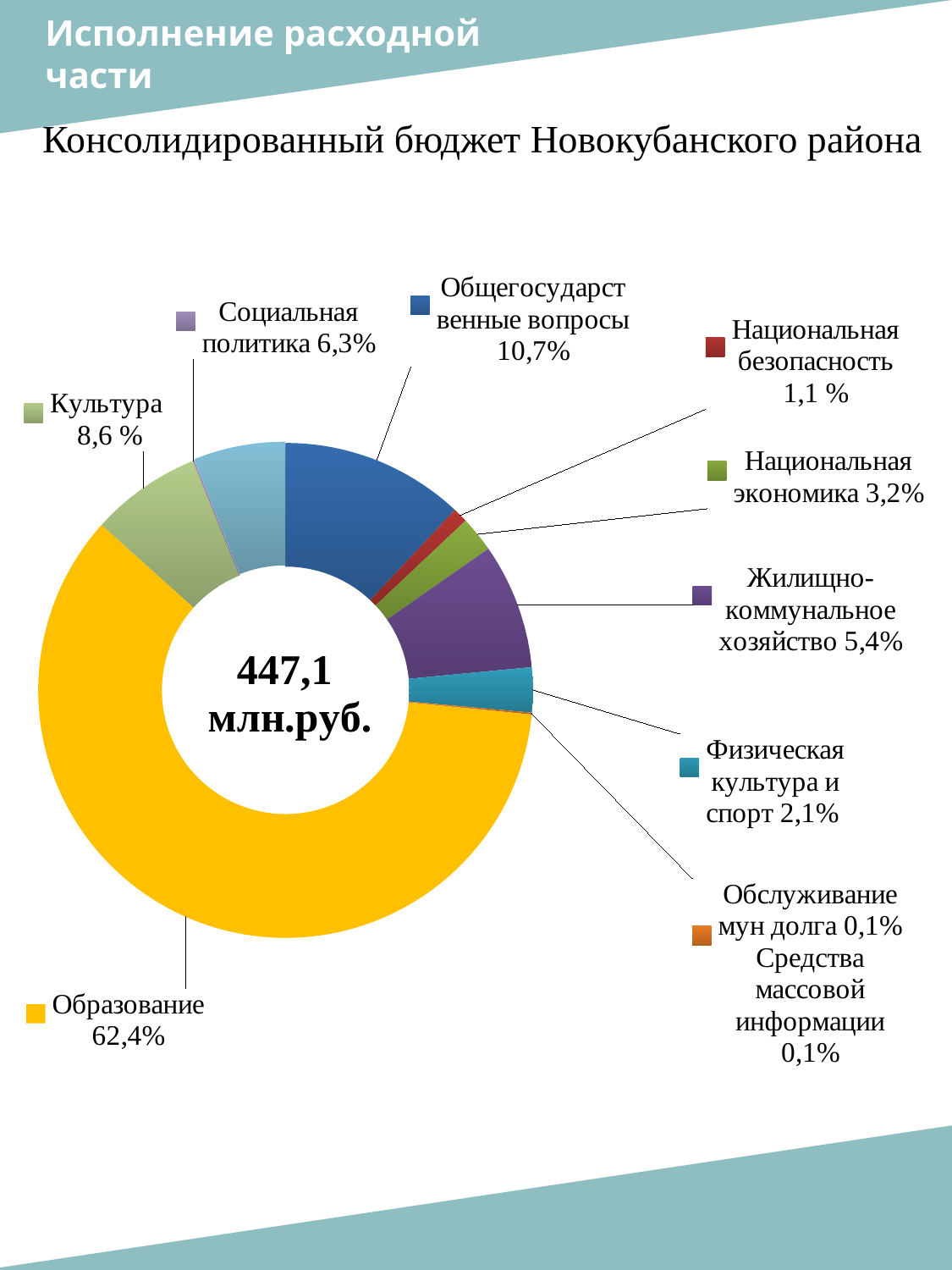
What share is shown for Общегосударственные вопросы? 10,7% What share of the consolidated budget expenditure goes to Образование? 62,4% Which category has the largest share of the chart? Образование What share is shown for Физическая культура и спорт? 2,1% Which has the larger share: Культура or Жилищно-коммунальное хозяйство? Культура What is the difference in percentage points between Образование and Общегосударственные вопросы? 51,7 What share is shown for Национальная безопасность? 1,1 % What share is shown for Жилищно-коммунальное хозяйство? 5,4% What share is shown for Культура? 8,6 % What kind of chart is shown on the slide? Doughnut (pie) chart Which has the larger share: Социальная политика or Национальная экономика? Социальная политика What total amount is printed in the centre of the chart? 447,1 млн.руб.